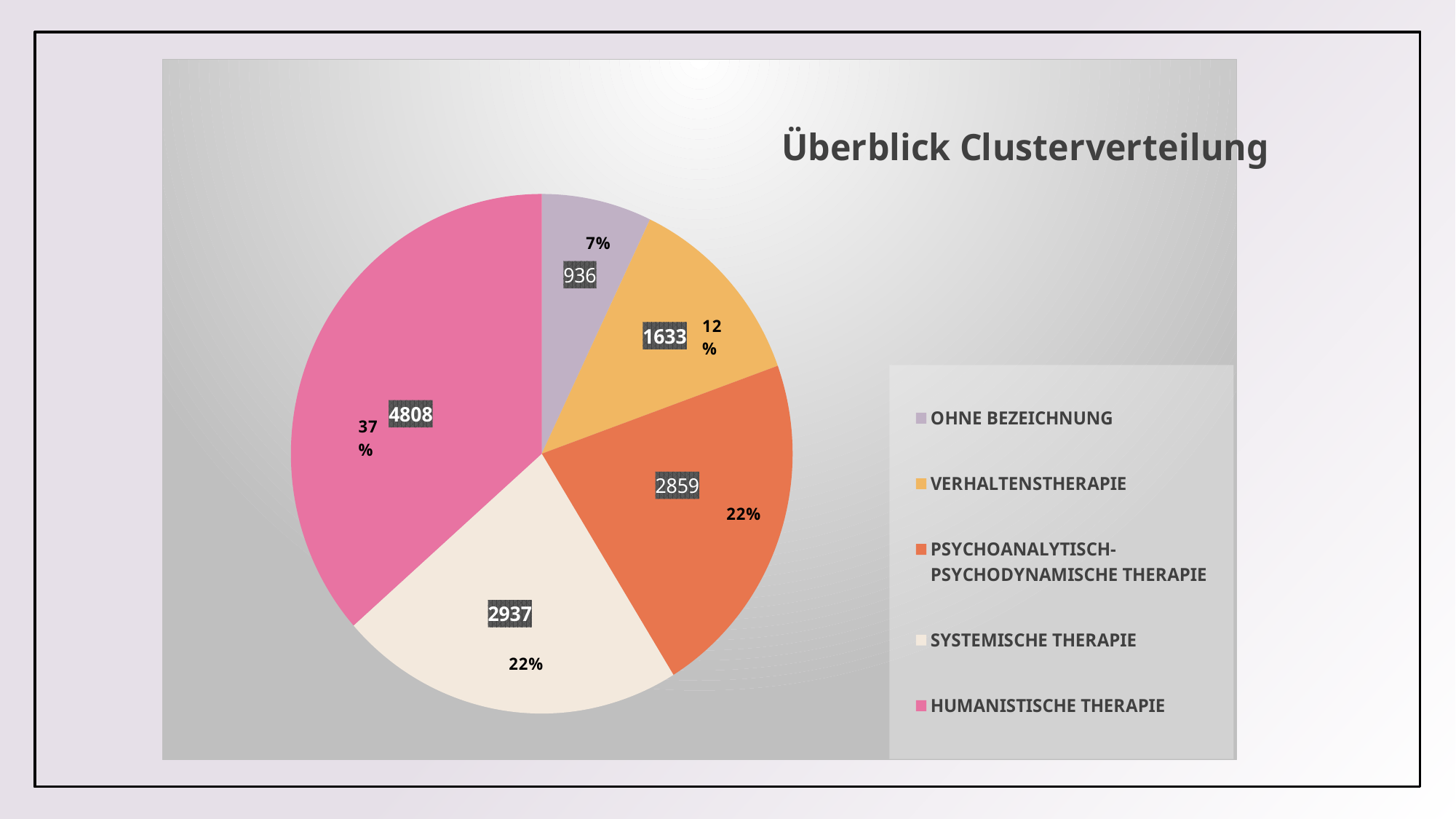
Which is larger, the value for Verhaltenstherapie or the value for Ohne Bezeichnung? Verhaltenstherapie What share of the pie does Humanistische Therapie represent? 37% Which category has the smallest slice? Ohne Bezeichnung What is the value for Humanistische Therapie? 4808 What is the difference between the values for Humanistische Therapie and Psychoanalytisch-Psychodynamische Therapie? 1949 What is the value for Ohne Bezeichnung? 936 What is the title of the chart? Überblick Clusterverteilung How many slices does the pie chart have? 5 What type of chart is shown on the slide? Pie chart Which category has the largest slice? Humanistische Therapie What is the value for Verhaltenstherapie? 1633 What is the value for Systemische Therapie? 2937